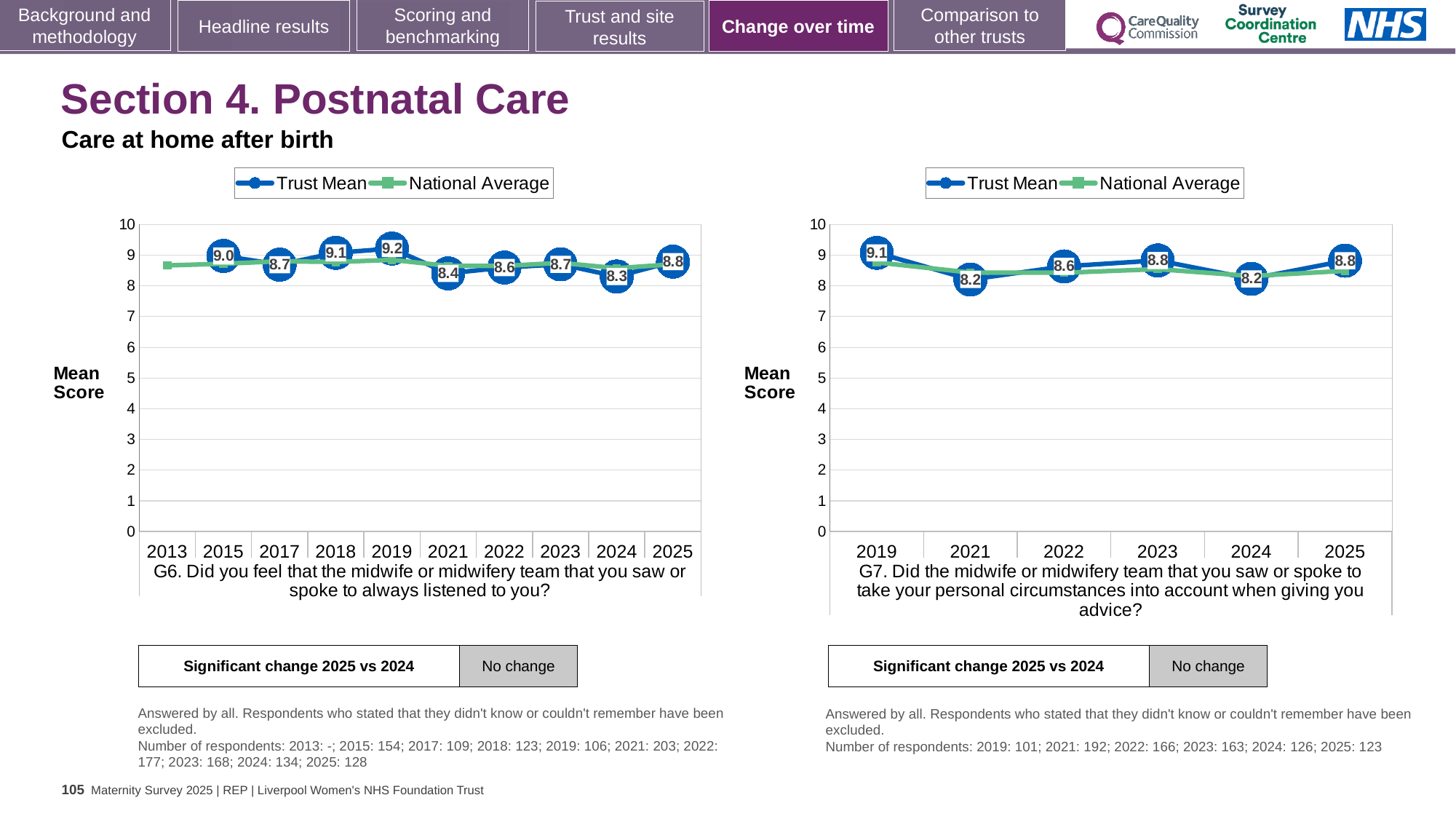
In the left chart (G6), which year has the lowest Trust Mean? 2024 In the left chart (G6), what is the Trust Mean for 2024? 8.3 How many series does the legend of the right chart (G7) list? 2 What type of chart is the left chart (G6)? Line chart In the right chart (G7), what is the difference between the Trust Mean in 2019 and in 2024? 0.9 In the left chart (G6), what is the difference between the Trust Mean in 2025 and in 2024? 0.5 In the left chart (G6), which year has the highest Trust Mean? 2019 In the right chart (G7), what is the Trust Mean for 2021? 8.2 In the right chart (G7), is the Trust Mean higher in 2023 or in 2024? 2023 In the right chart (G7), which year has the highest Trust Mean? 2019 In the left chart (G6), how many years are shown on the x axis? 10 In the left chart (G6), what is the Trust Mean for 2019? 9.2